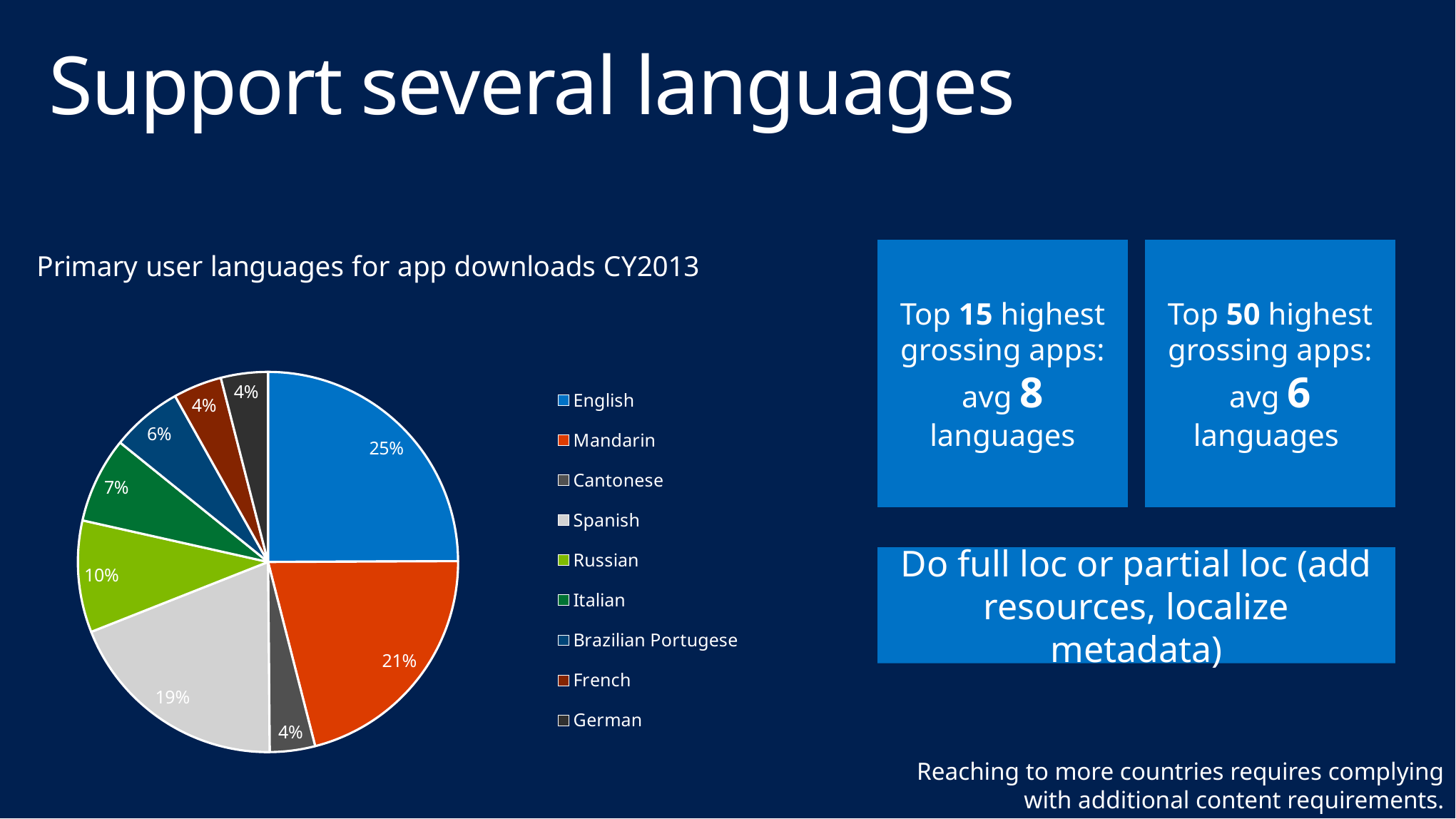
Which is larger, the share for Spanish or the share for Russian? Spanish What is the difference between the English and Mandarin shares? 4% What share of the pie does Spanish have? 19% What share of the pie does English have? 25% What share of the pie does Brazilian Portugese have? 6% What share of the pie does Mandarin have? 21% What share of the pie does Italian have? 7% What is the chart's title? Primary user languages for app downloads CY2013 How many languages are listed in the legend? 9 Which language has the largest slice of the pie? English What share of the pie does Russian have? 10% What kind of chart is shown on the slide? pie chart